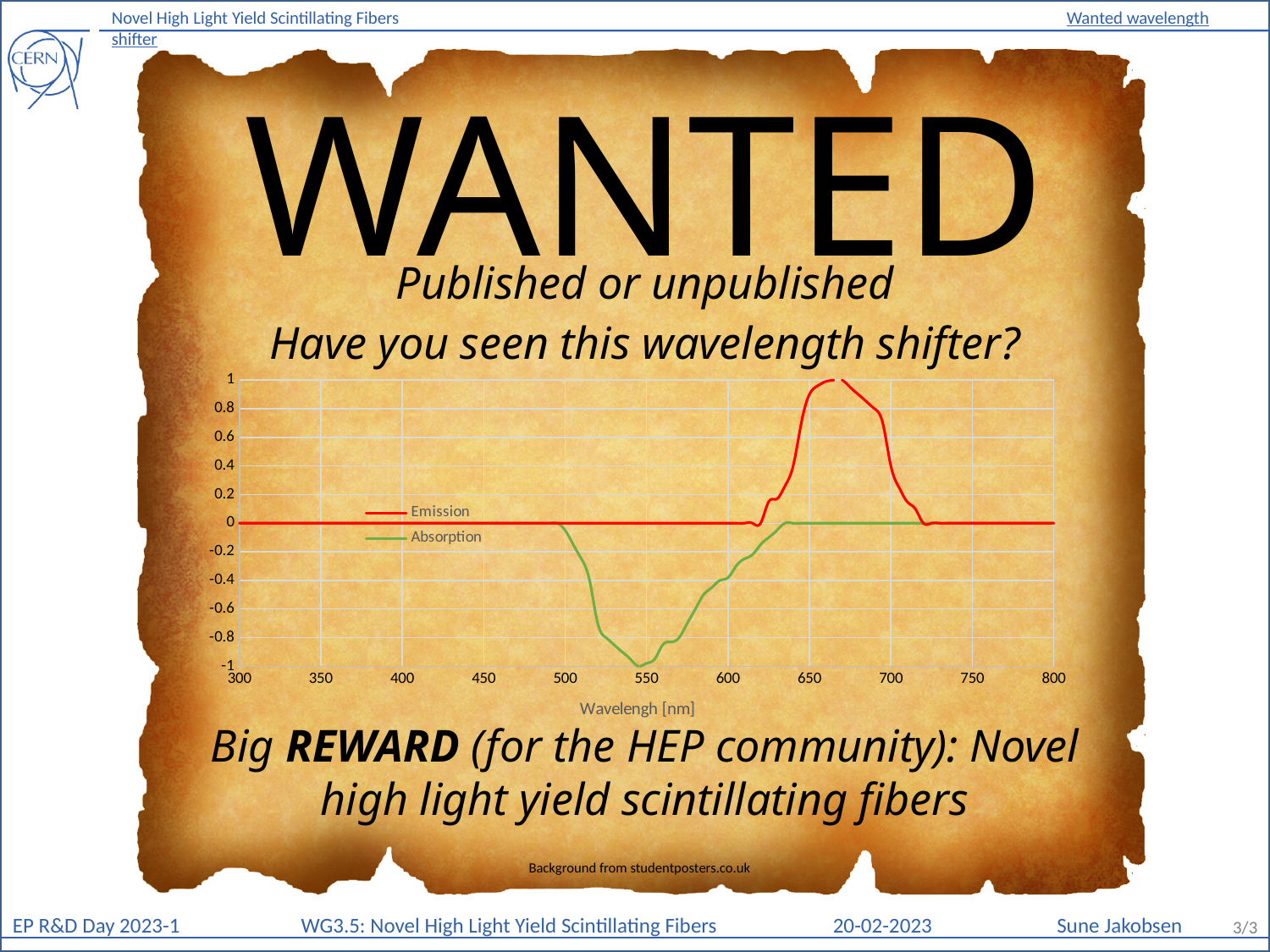
Is the Absorption value at 400 nm greater or less than -0.2? greater What are the two series named in the chart's legend? Emission and Absorption At 550 nm, which series has the larger value, Emission or Absorption? Emission Does the Absorption curve rise or fall between 550 nm and 650 nm? rise How many series does the chart's legend list? 2 Is the Emission value at 650 nm greater or less than 0.6? greater Does the Emission curve rise or fall between 650 nm and 700 nm? fall Which series reaches the higher maximum value on the chart? Emission Is the Absorption value at 550 nm greater or less than -0.6? less What kind of chart is shown on the slide? line chart What is the title of the chart's x axis? Wavelengh [nm]